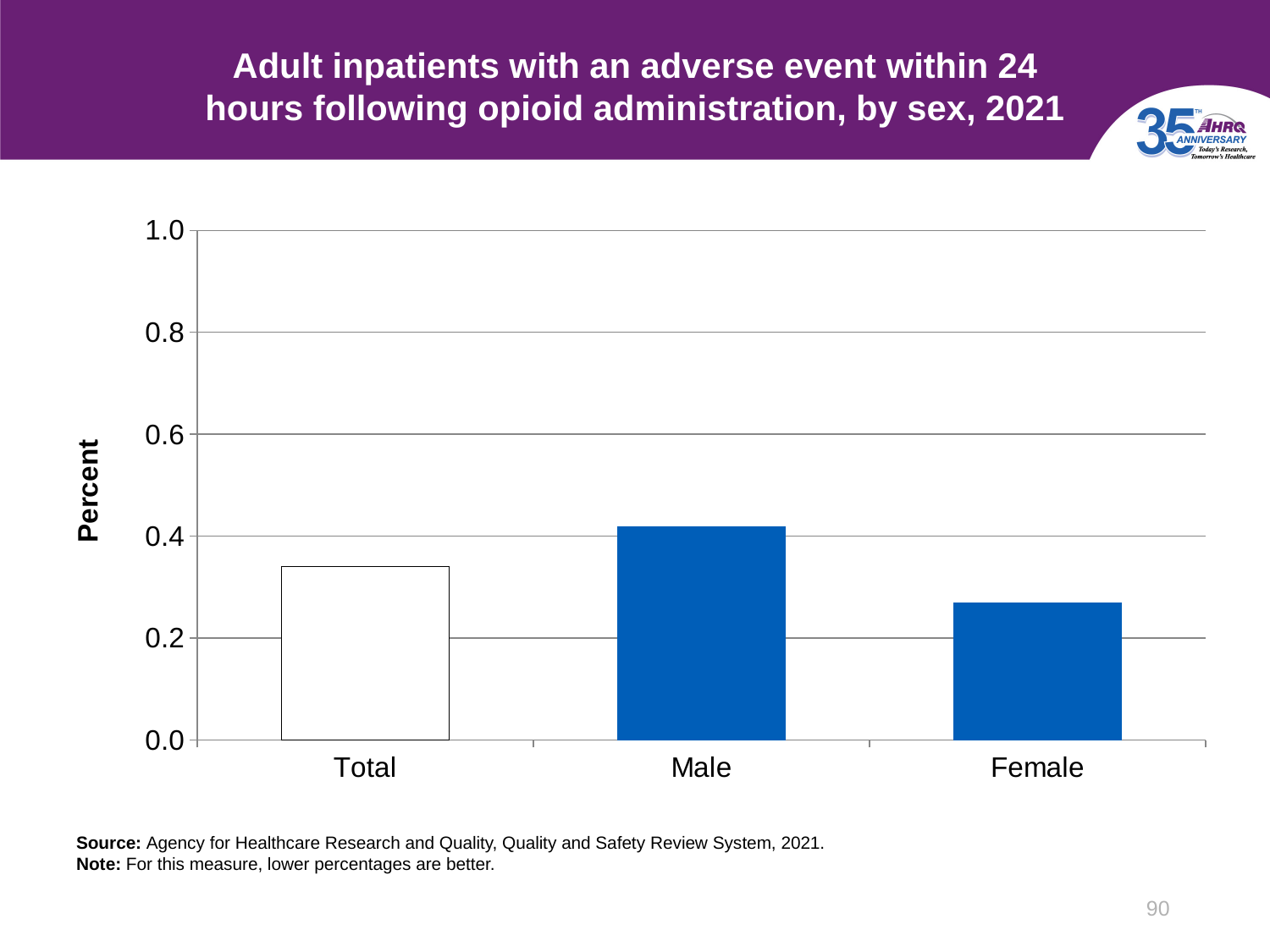
Is the value for Total greater or less than 0.4? less What year does the chart title say the data are from? 2021 What is the label on the y axis of the chart? Percent Which is larger, the value for Total or the value for Female? Total Which is larger, the value for Male or the value for Total? Male Which category has the highest value in the chart? Male How many categories are shown on the x axis of the chart? 3 Which is larger, the value for Male or the value for Female? Male What kind of chart is shown on the slide? bar chart Which category has the lowest value in the chart? Female Is the value for Female greater or less than 0.2? greater Is the value for Male greater or less than 0.6? less